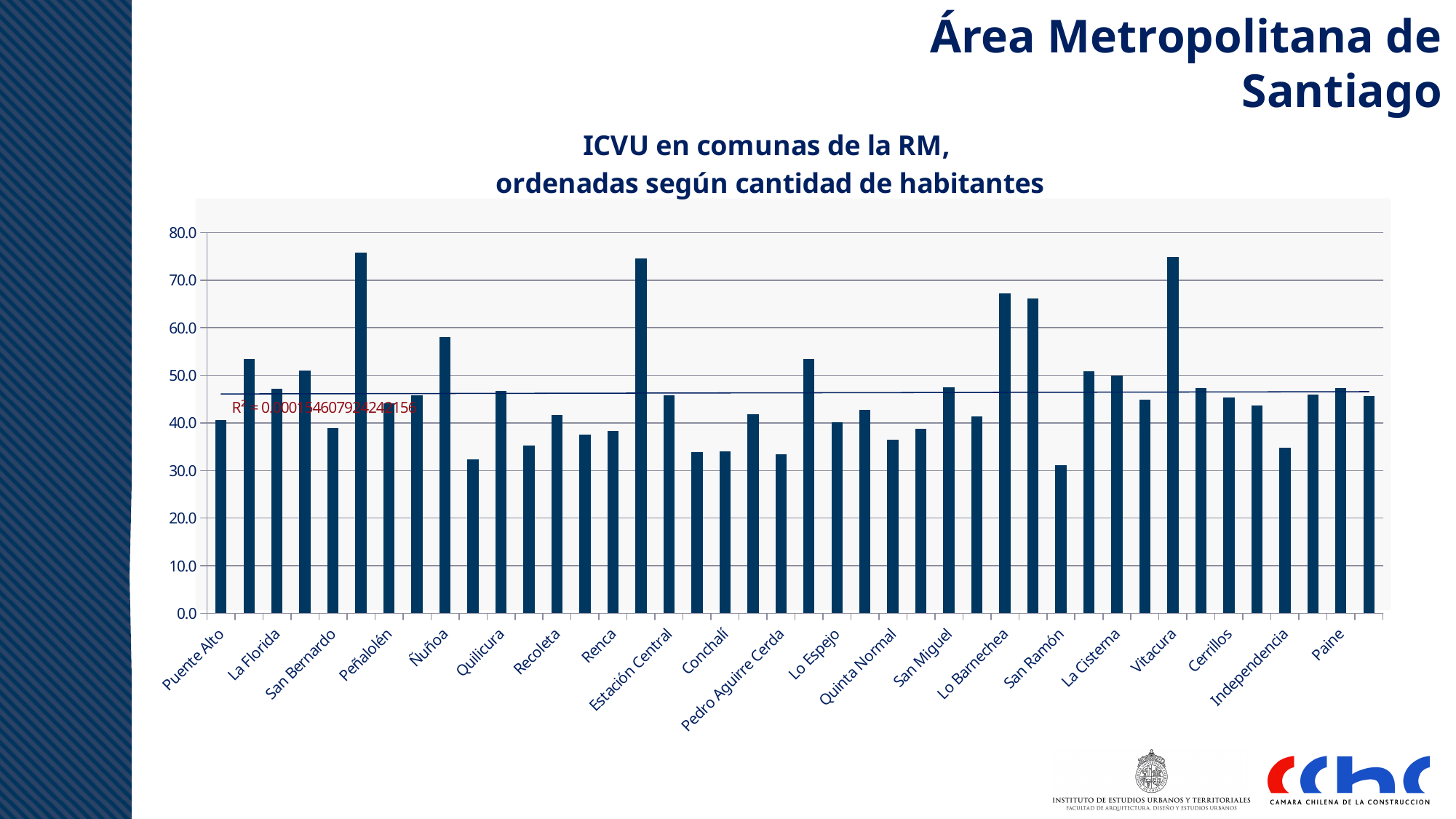
Is the value for Lo Barnechea greater or less than 60? greater Is the value for San Ramón greater or less than 40? less Does the trendline drawn across the bars rise, fall, or stay roughly flat from left to right? roughly flat Which has the larger value, Vitacura or San Ramón? Vitacura Which has the larger value, Lo Barnechea or Lo Espejo? Lo Barnechea Is the value for Quinta Normal greater or less than 40? less What is the title of the chart? ICVU en comunas de la RM, ordenadas según cantidad de habitantes Which has the larger value, Ñuñoa or Recoleta? Ñuñoa What kind of chart is shown on the slide? bar chart